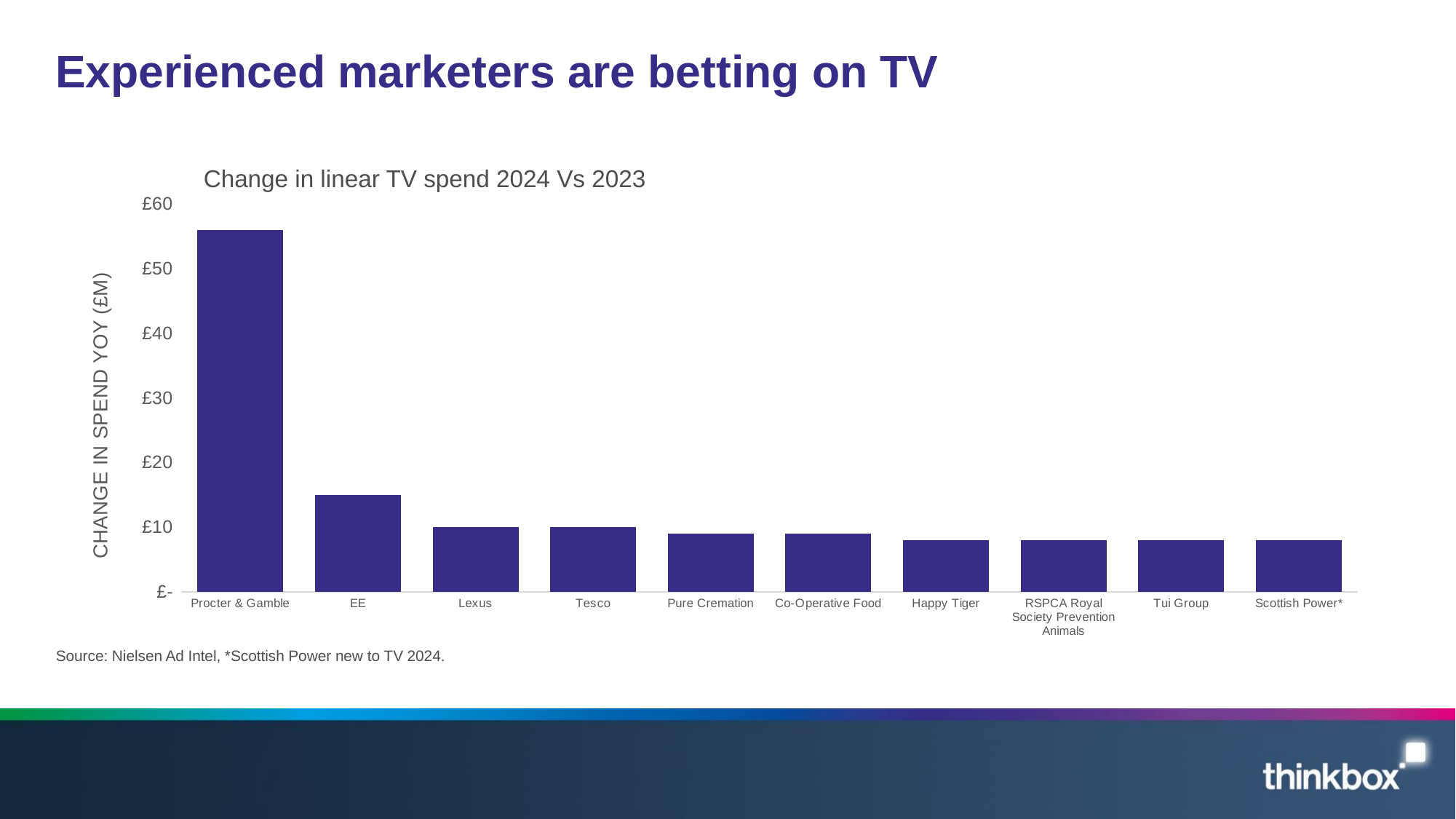
What is the title of the chart? Change in linear TV spend 2024 Vs 2023 Is the value for Pure Cremation greater or less than £10? less Is the value for EE greater or less than £10? greater Which advertiser has the largest change in linear TV spend? Procter & Gamble Do the values generally rise or fall moving from left to right across the chart? fall Is the value for Procter & Gamble greater or less than £50? greater What is the label on the vertical axis of the chart? CHANGE IN SPEND YOY (£M) What type of chart is shown on the slide? Bar chart How many advertisers (categories) are shown in the chart? 10 Which has a larger change in spend, EE or Lexus? EE